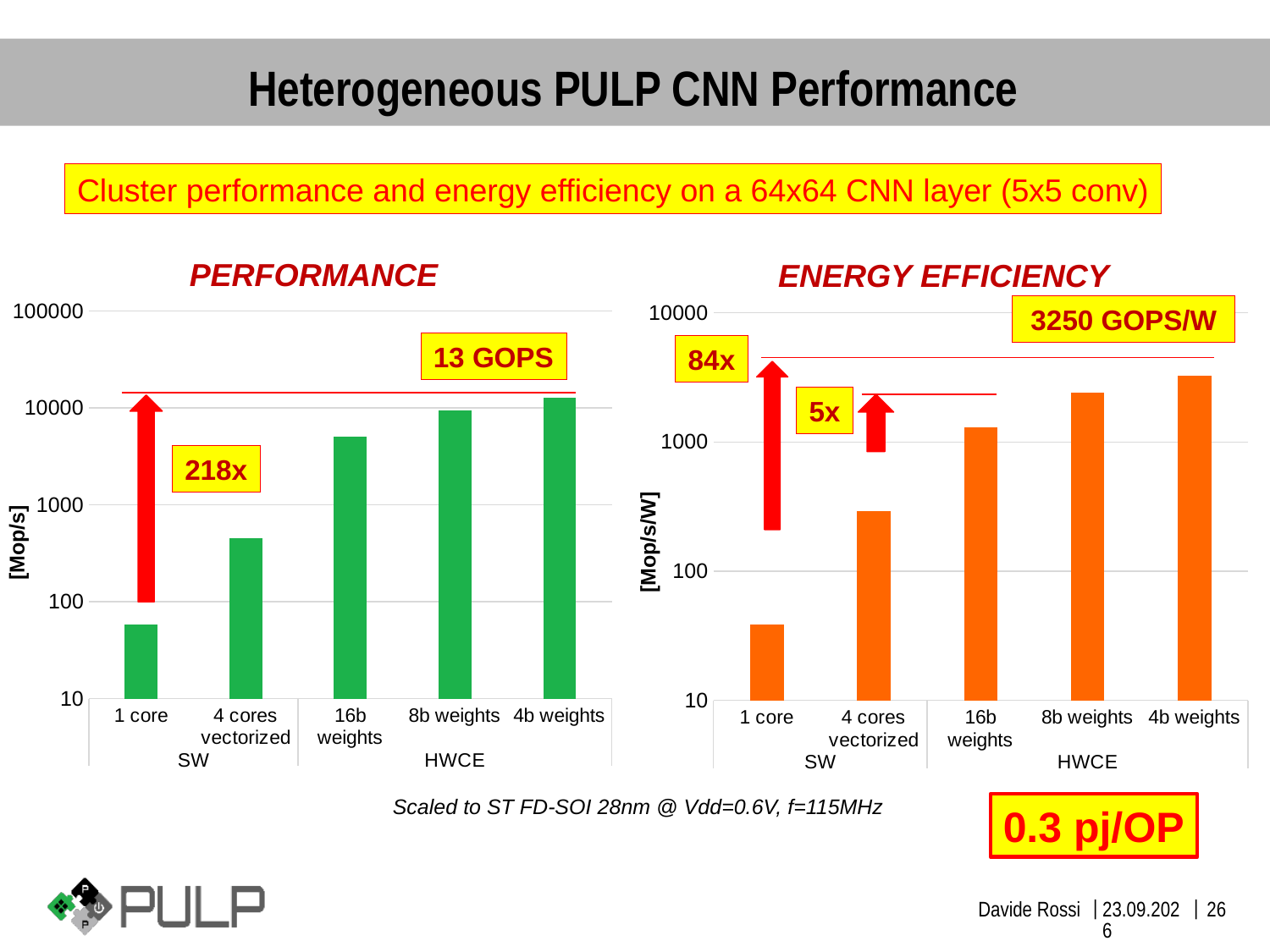
In the ENERGY EFFICIENCY chart, which category has the highest value? 4b weights In the ENERGY EFFICIENCY chart, which category has the lowest value? 1 core What kind of chart is the PERFORMANCE chart? bar chart In the PERFORMANCE chart, is the value for 1 core greater or less than 100? less How many categories are shown on the ENERGY EFFICIENCY chart? 5 In the ENERGY EFFICIENCY chart, is the value for 8b weights greater or less than 1000? greater In the PERFORMANCE chart, which category has the highest value? 4b weights In the ENERGY EFFICIENCY chart, is the value for 4 cores vectorized greater or less than 1000? less In the PERFORMANCE chart, which category has the lowest value? 1 core In the PERFORMANCE chart, do the values rise or fall from left to right along the x axis? rise What is the y-axis label of the ENERGY EFFICIENCY chart? [Mop/s/W]